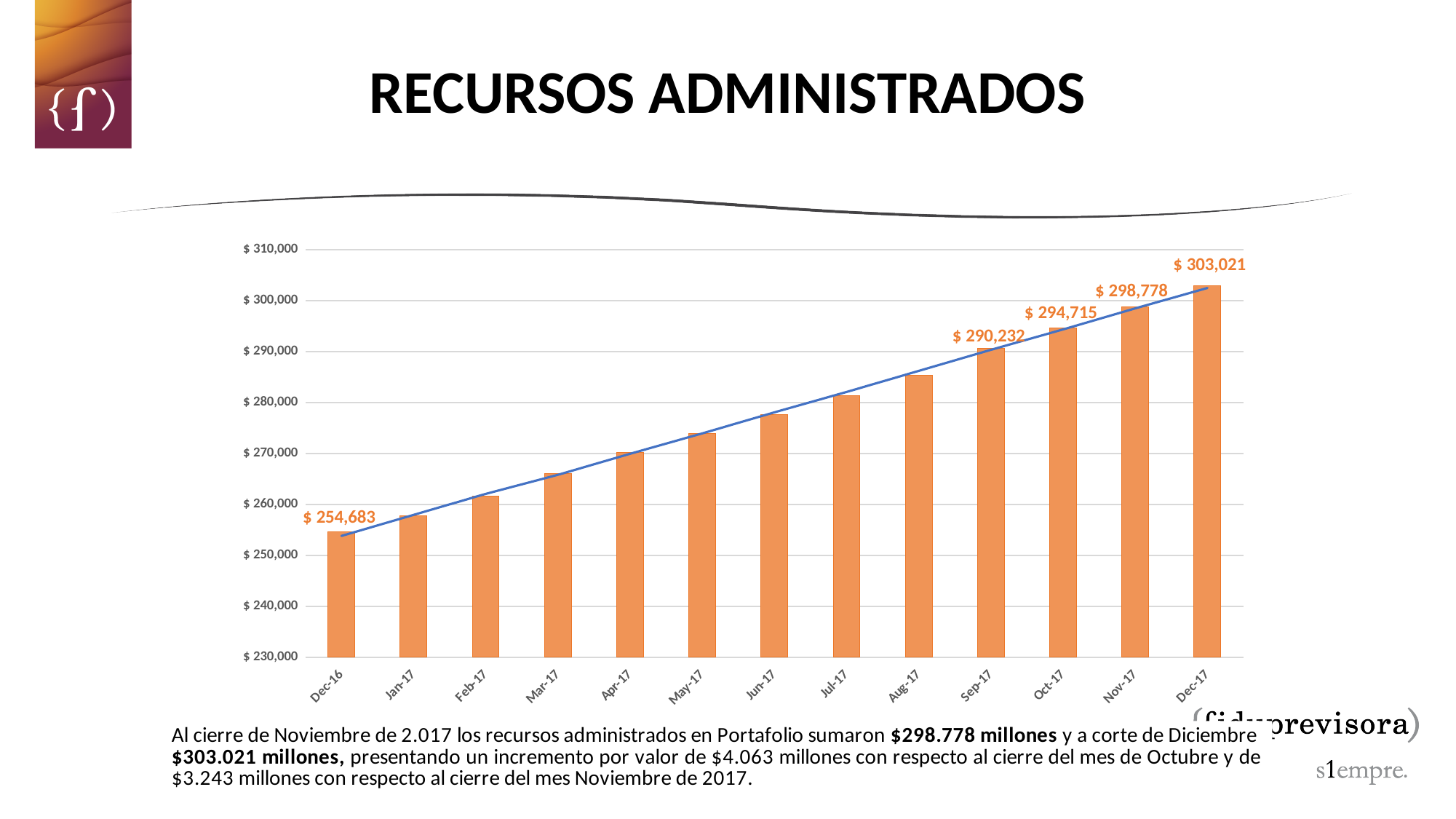
Which month has the highest value? Dec-17 Which is larger, the value for Oct-17 or the value for Sep-17? Oct-17 What is the value for Oct-17? $ 294,715 Which month has the lowest value? Dec-16 What is the difference between the values for Dec-17 and Nov-17? $ 4,243 Do the values rise or fall from Dec-16 to Dec-17? rise How many months are shown on the x axis? 13 What kind of chart is shown on the slide? bar chart What is the value for Sep-17? $ 290,232 What is the value for Dec-16? $ 254,683 Is the value for Jun-17 greater or less than $ 280,000? less What is the value for Dec-17? $ 303,021